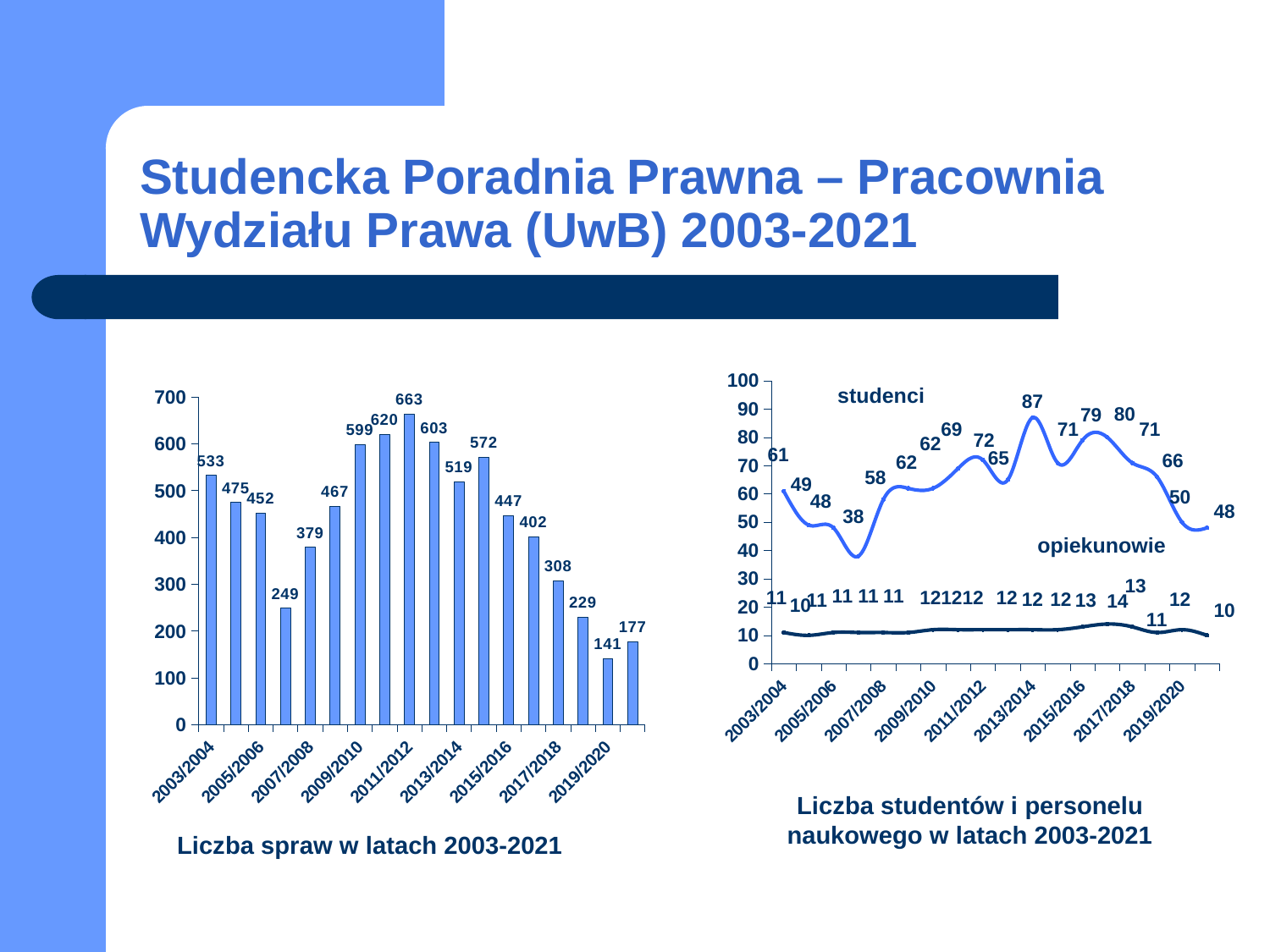
In the chart titled 'Liczba studentów i personelu naukowego w latach 2003-2021', what is the value of the 'opiekunowie' series for 2003/2004? 11 In the chart titled 'Liczba studentów i personelu naukowego w latach 2003-2021', how many series are plotted? 2 What kind of chart is the one titled 'Liczba spraw w latach 2003-2021'? bar chart In the chart titled 'Liczba spraw w latach 2003-2021', which year has the highest value? 2011/2012 In the chart titled 'Liczba spraw w latach 2003-2021', how many bars are plotted? 18 In the chart titled 'Liczba spraw w latach 2003-2021', what is the value for 2003/2004? 533 In the chart titled 'Liczba studentów i personelu naukowego w latach 2003-2021', which series is higher for 2015/2016, 'studenci' or 'opiekunowie'? studenci In the chart titled 'Liczba studentów i personelu naukowego w latach 2003-2021', what is the value of the 'studenci' series for 2013/2014? 87 In the chart titled 'Liczba spraw w latach 2003-2021', which year has the lowest value? 2019/2020 In the chart titled 'Liczba spraw w latach 2003-2021', what is the difference between the values for 2009/2010 and 2019/2020? 458 In the chart titled 'Liczba spraw w latach 2003-2021', what is the value for 2011/2012? 663 In the chart titled 'Liczba studentów i personelu naukowego w latach 2003-2021', what is the lowest value of the 'studenci' series? 38